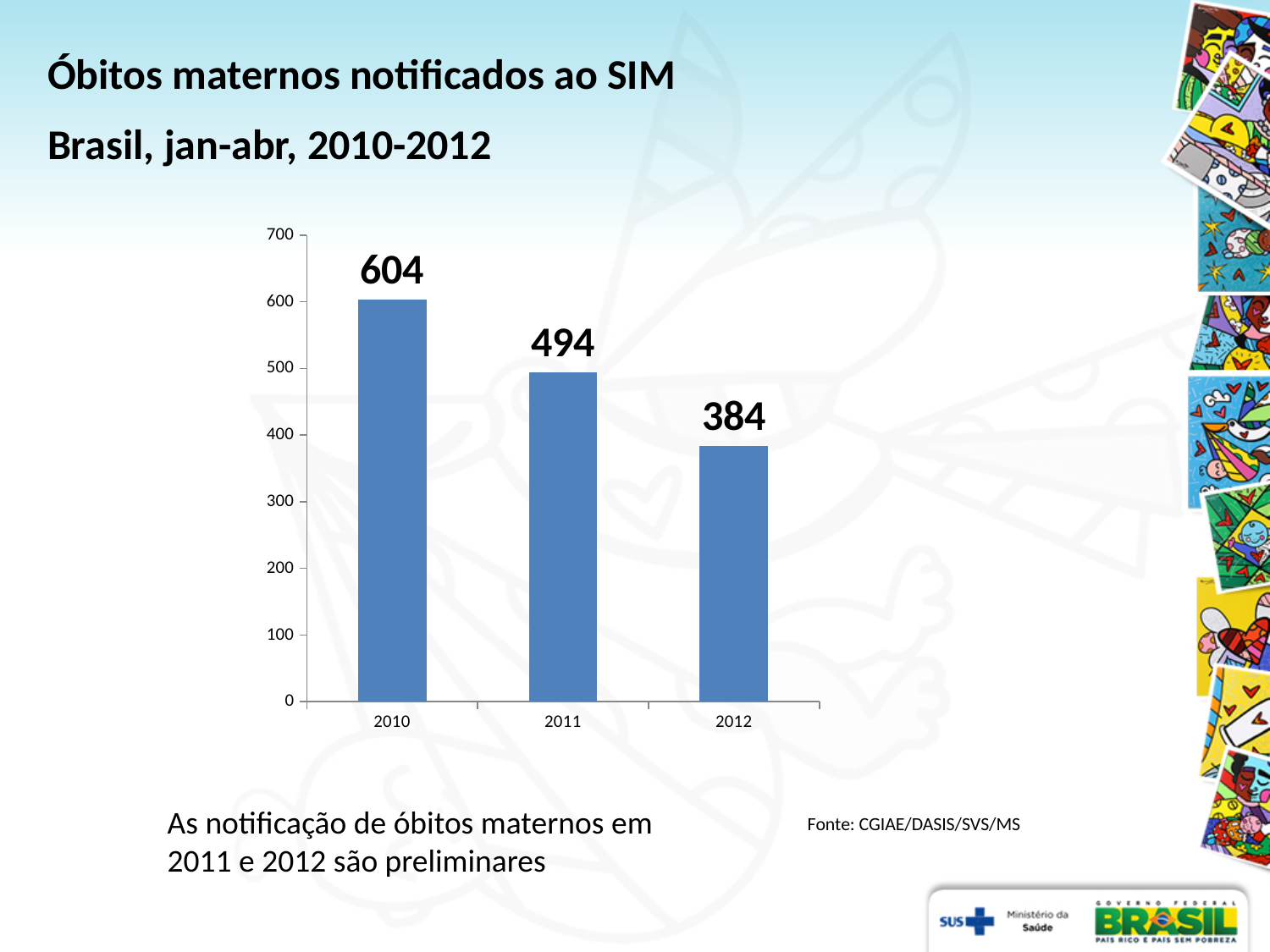
How many years are shown on the x axis? 3 Which is larger, the value for 2011 or the value for 2012? 2011 What kind of chart is shown on the slide? bar chart Do the values rise or fall from 2010 to 2012? fall What is the difference between the values for 2010 and 2012? 220 Which year has the lowest value? 2012 What is the difference between the values for 2010 and 2011? 110 Which year has the highest value? 2010 What is the value for 2012? 384 What is the value for 2010? 604 Is the value for 2012 greater or less than 400? less What is the value for 2011? 494